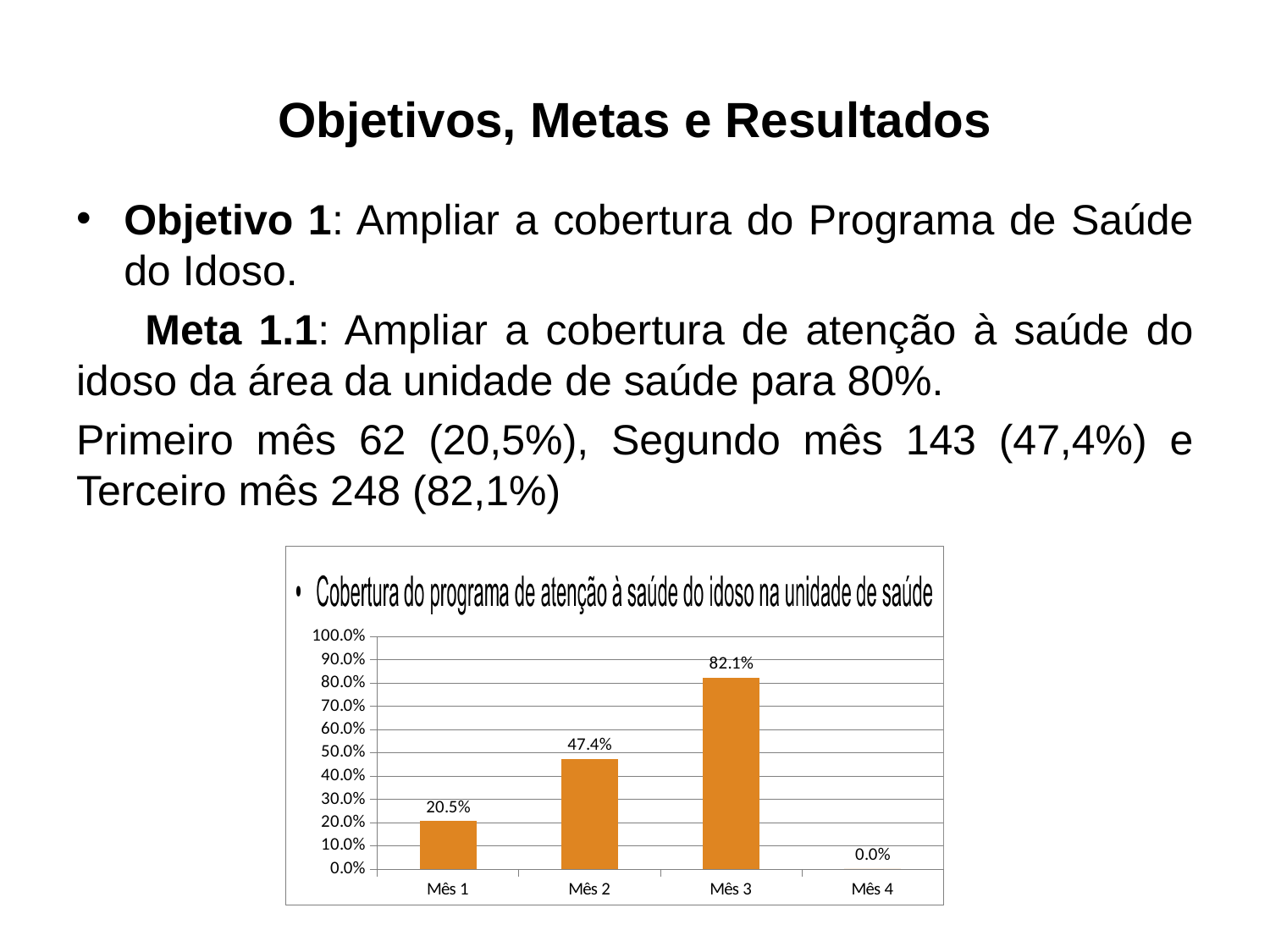
Which category has the highest value? Mês 3 Which is larger, the value for Mês 1 or the value for Mês 2? Mês 2 Is the value for Mês 3 greater or less than 80.0%? greater What is the value for Mês 4? 0.0% What is the value for Mês 3? 82.1% What is the value for Mês 1? 20.5% What is the title of the chart? Cobertura do programa de atenção à saúde do idoso na unidade de saúde What is the difference between the values for Mês 3 and Mês 2? 34.7% Which category has the lowest value? Mês 4 What is the value for Mês 2? 47.4% What kind of chart is shown on the slide? bar chart How many categories are shown on the x axis? 4